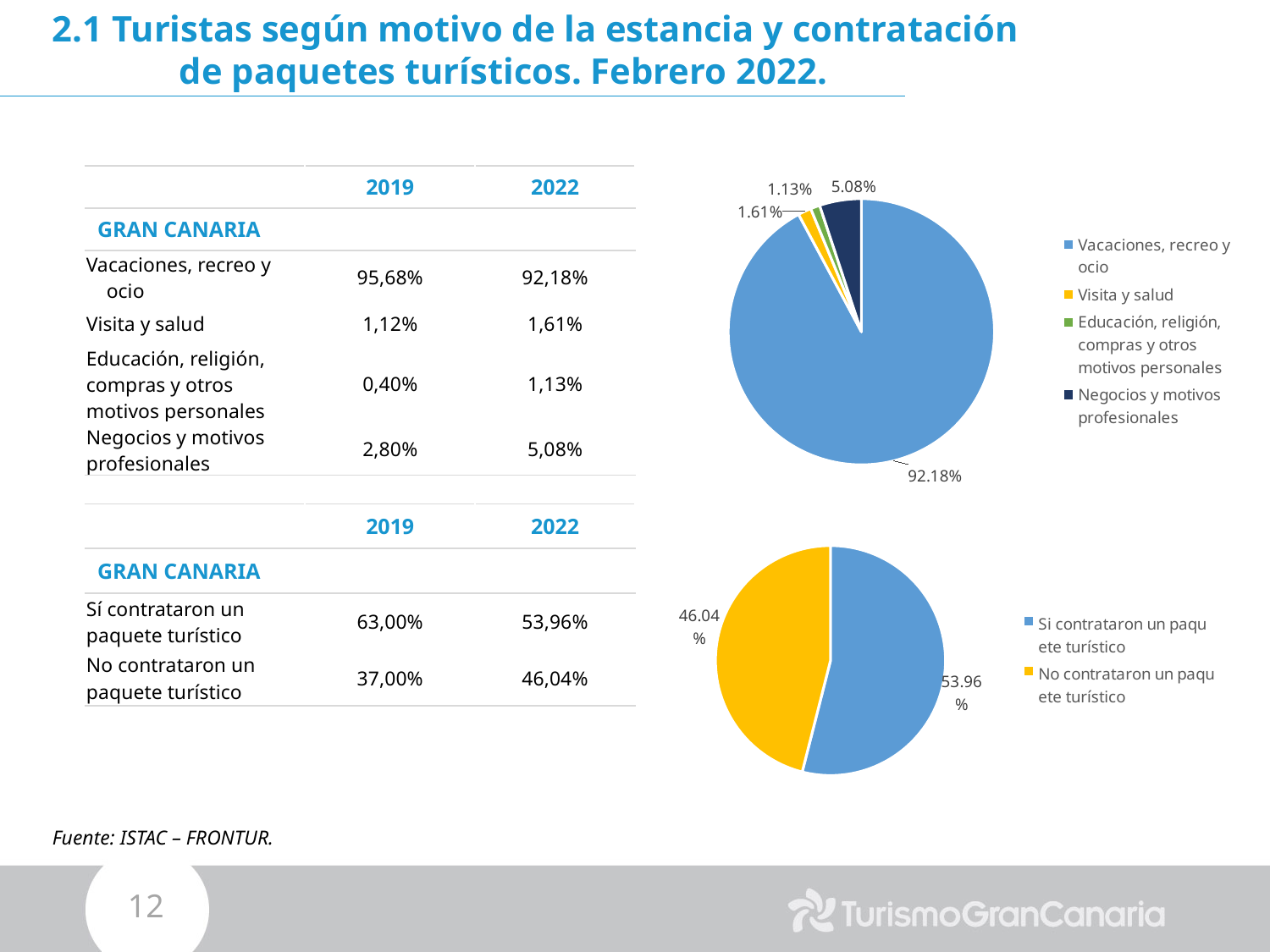
In the top pie chart, which category has the largest slice? Vacaciones, recreo y ocio What kind of chart is the top chart on the right of the slide? Pie chart In the bottom pie chart, which category has the larger slice? Sí contrataron un paquete turístico In the bottom pie chart, what share is shown for 'Sí contrataron un paquete turístico'? 53.96% In the top pie chart, which is larger: the slice for 'Negocios y motivos profesionales' or the slice for 'Visita y salud'? Negocios y motivos profesionales In the top pie chart, what share is shown for 'Vacaciones, recreo y ocio'? 92.18% In the bottom pie chart, what share is shown for 'No contrataron un paquete turístico'? 46.04% How many categories does the legend of the top pie chart list? 4 In the bottom pie chart, what colour is the slice for 'No contrataron un paquete turístico'? Yellow In the top pie chart, which category has the smallest slice? Educación, religión, compras y otros motivos personales